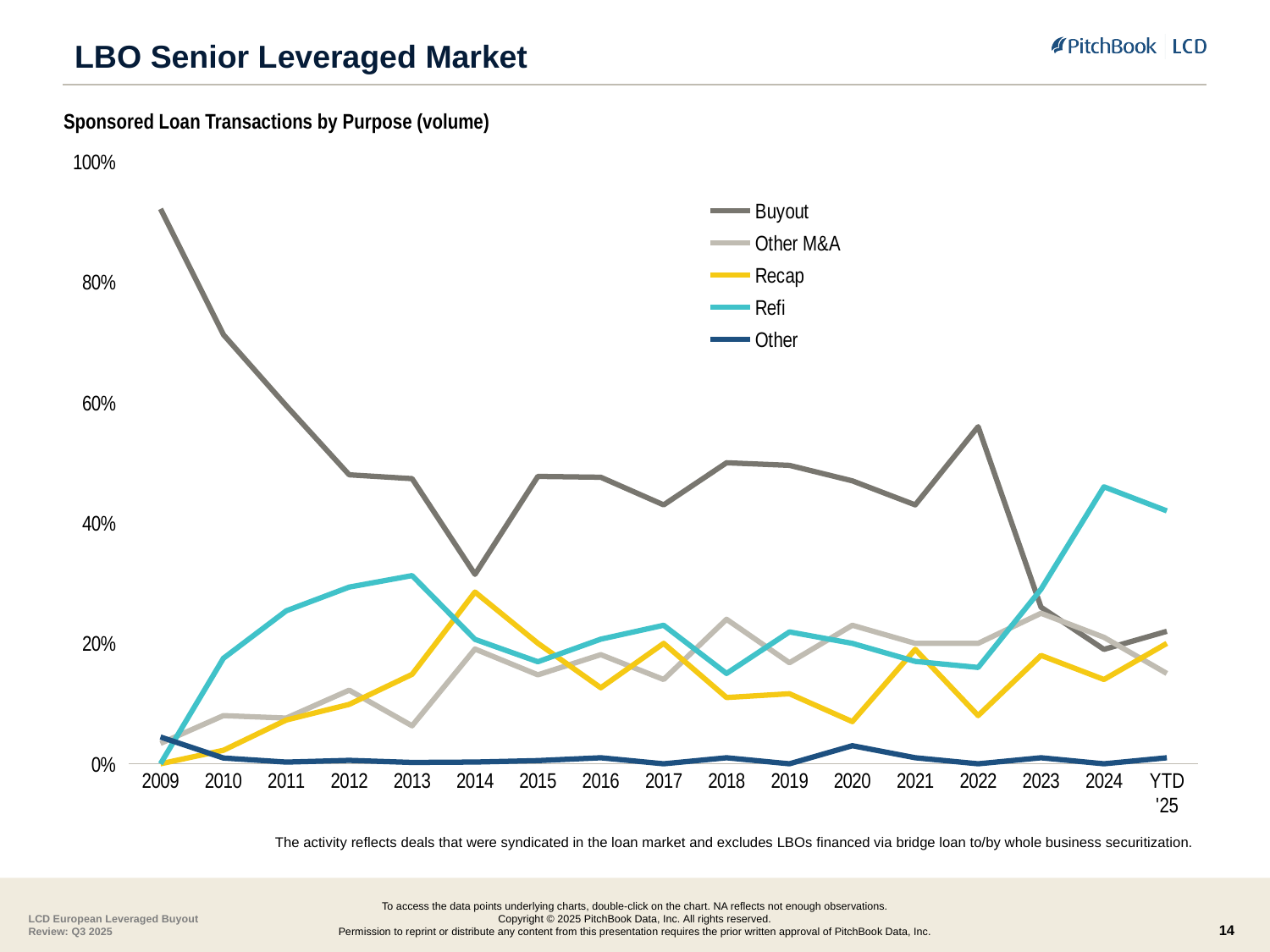
What is the title of the chart? Sponsored Loan Transactions by Purpose (volume) Is the value for Buyout in 2022 greater or less than 40%? greater Which series has the highest value in 2009? Buyout Which series has the highest value in 2024? Refi Is the value for Refi in 2024 greater or less than 40%? greater How many time periods are shown along the x axis? 17 In which year does the Buyout series reach its highest value? 2009 Is the value for Buyout in 2009 greater or less than 80%? greater Does the Buyout series rise or fall from 2009 to 2014? fall What kind of chart is shown on the slide? Line chart How many series does the legend list? 5 Which is larger in 2022, Buyout or Refi? Buyout